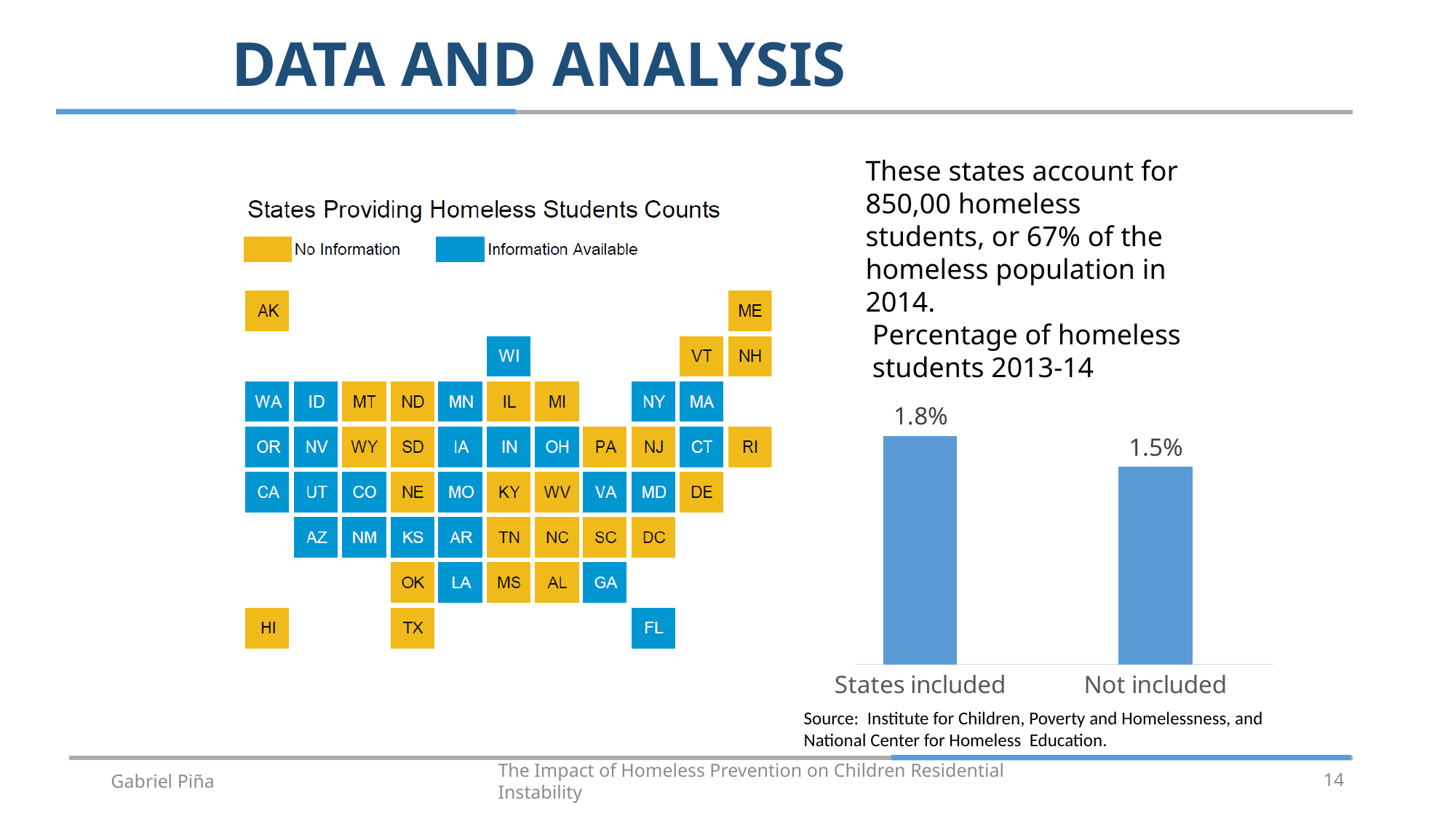
In the bar chart 'Percentage of homeless students 2013-14', what is the difference between States included and Not included? 0.3% In the bar chart 'Percentage of homeless students 2013-14', what is the value for Not included? 1.5% In the chart 'States Providing Homeless Students Counts', what does the yellow colour represent according to the legend? No Information What kind of chart is the chart on the right side of the slide? bar chart In the chart 'States Providing Homeless Students Counts', is CA shown as 'No Information' or 'Information Available'? Information Available In the bar chart 'Percentage of homeless students 2013-14', which category has the higher value? States included In the bar chart 'Percentage of homeless students 2013-14', which category has the lower value? Not included In the bar chart 'Percentage of homeless students 2013-14', is the value for Not included larger or smaller than the value for States included? smaller What is the title of the chart on the left side of the slide? States Providing Homeless Students Counts In the chart 'States Providing Homeless Students Counts', is TX shown as 'No Information' or 'Information Available'? No Information How many bars are shown in the bar chart 'Percentage of homeless students 2013-14'? 2 In the bar chart 'Percentage of homeless students 2013-14', what is the value for States included? 1.8%